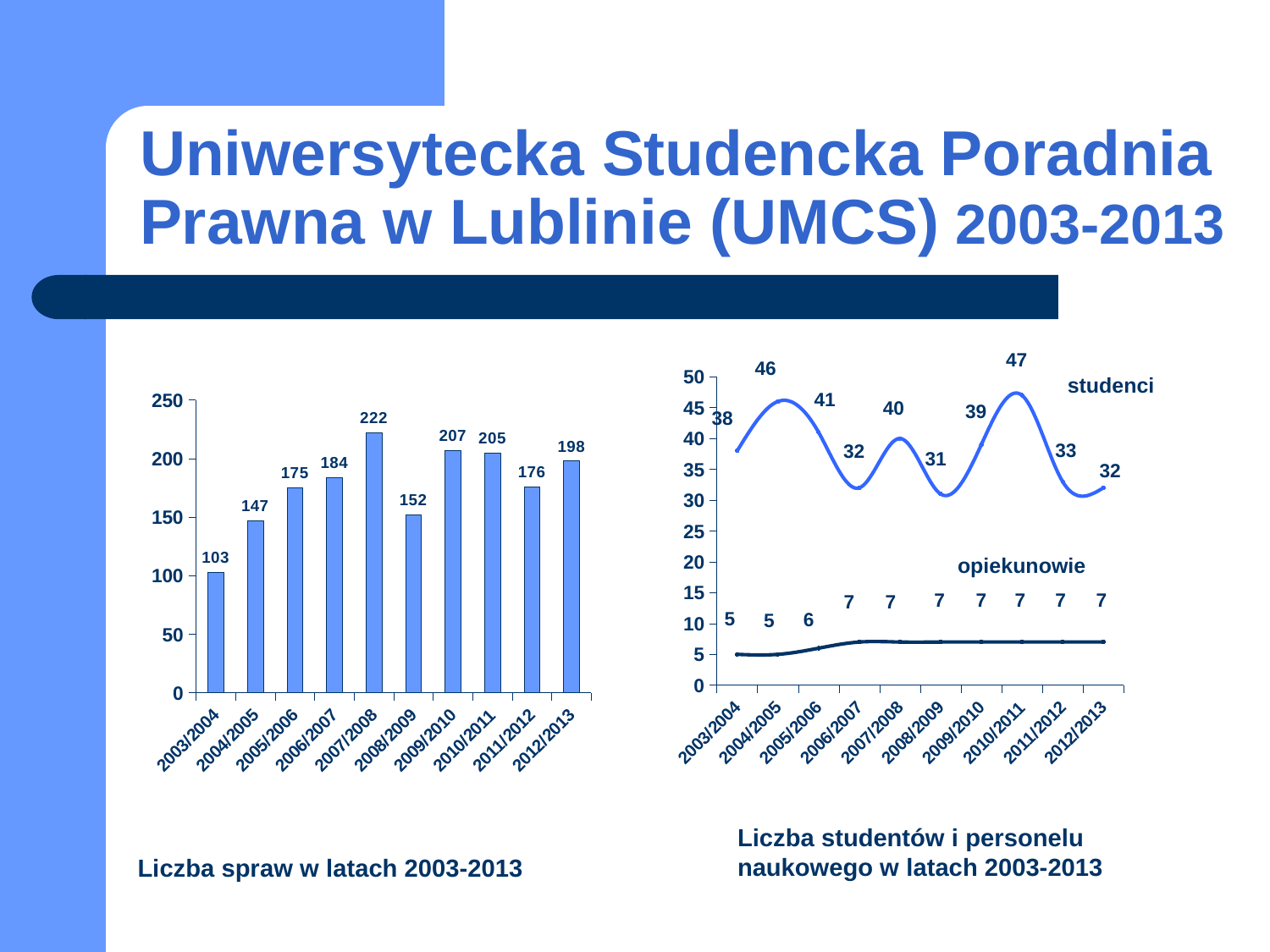
In the left chart (Liczba spraw w latach 2003-2013), what is the difference between the values for 2009/2010 and 2008/2009? 55 In the left chart (Liczba spraw w latach 2003-2013), which year has the lowest value? 2003/2004 In the right chart (Liczba studentów i personelu naukowego), what is the value for studenci in 2010/2011? 47 In the left chart (Liczba spraw w latach 2003-2013), what is the value for 2007/2008? 222 In the right chart (Liczba studentów i personelu naukowego), which year has the lowest value for studenci? 2008/2009 In the right chart (Liczba studentów i personelu naukowego), what is the difference between the studenci value and the opiekunowie value in 2004/2005? 41 What kind of chart is the right chart (Liczba studentów i personelu naukowego)? line chart In the right chart (Liczba studentów i personelu naukowego), what is the value for opiekunowie in 2005/2006? 6 In the left chart (Liczba spraw w latach 2003-2013), which is larger, the value for 2011/2012 or the value for 2012/2013? 2012/2013 In the left chart (Liczba spraw w latach 2003-2013), how many years are shown on the x axis? 10 In the left chart (Liczba spraw w latach 2003-2013), which year has the highest value? 2007/2008 What kind of chart is the left chart (Liczba spraw w latach 2003-2013)? bar chart